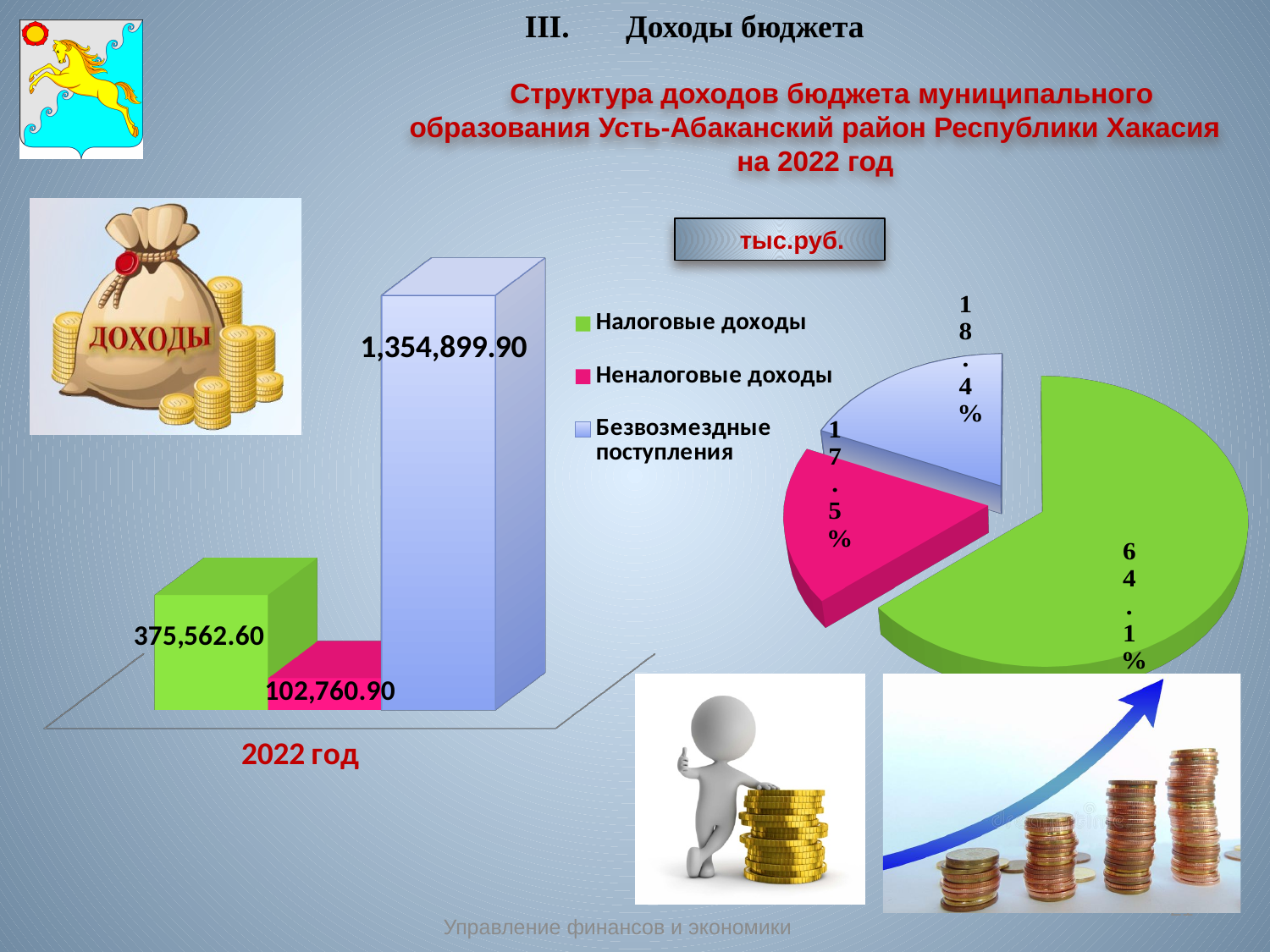
How many series does the legend list? 3 On the pie chart, what share does Неналоговые доходы have? 17.5% On the bar chart, what is the value for Налоговые доходы in 2022 год? 375,562.60 On the bar chart, which series has the highest value? Безвозмездные поступления On the pie chart, what share does Безвозмездные поступления have? 18.4% On the bar chart, what is the value for Безвозмездные поступления in 2022 год? 1,354,899.90 On the bar chart, which series has the lowest value? Неналоговые доходы On the bar chart, what is the difference between Налоговые доходы and Неналоговые доходы? 272,801.70 On the bar chart, which is larger: Налоговые доходы or Безвозмездные поступления? Безвозмездные поступления What unit is shown in the box above the charts? тыс.руб. On the bar chart, what is the value for Неналоговые доходы in 2022 год? 102,760.90 On the pie chart, what share does Налоговые доходы have? 64.1%